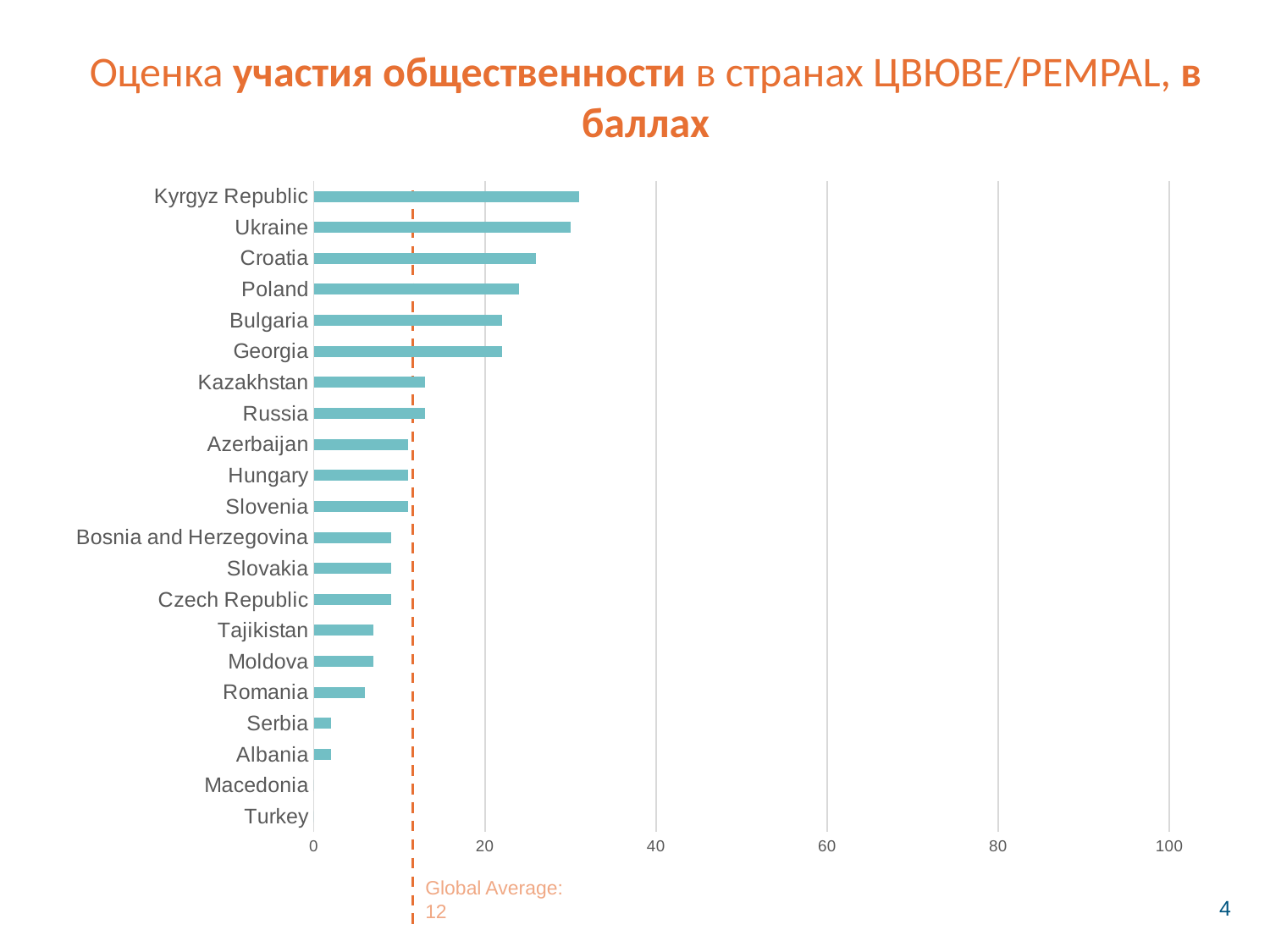
What kind of chart is shown on the slide? bar chart Is the value for Kazakhstan greater or less than 20? less Is the value for Romania greater or less than 20? less Is the value for Kyrgyz Republic greater or less than 20? greater What value is given for the Global Average on the chart? 12 Do the bar values decrease or increase going from the top of the chart to the bottom? decrease How many countries are listed on the chart? 21 Which has the larger value, Ukraine or Moldova? Ukraine Which has the larger value, Serbia or Poland? Poland Which has the larger value, Croatia or Romania? Croatia